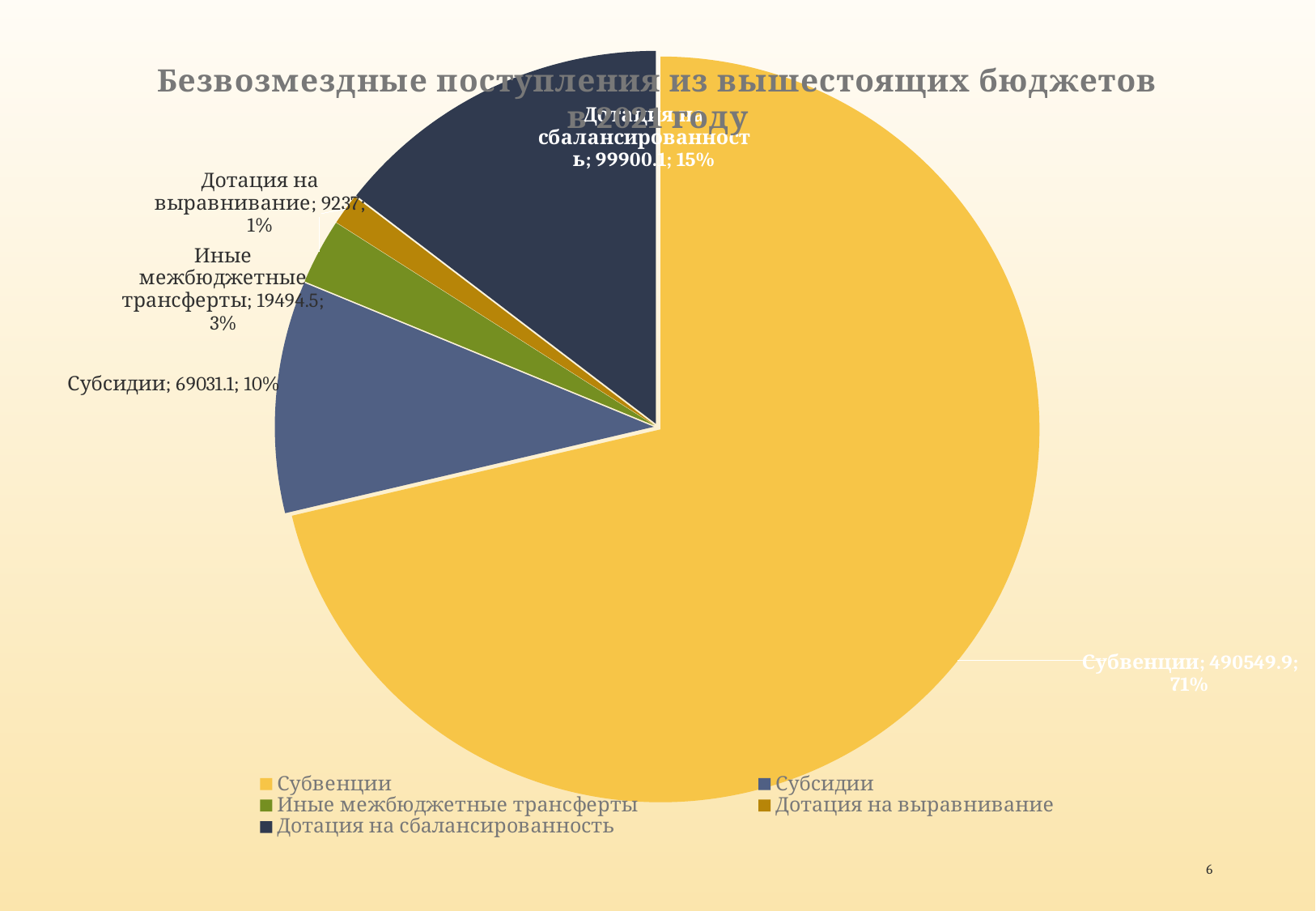
What is the difference between the values for Дотация на сбалансированность and Субсидии? 30869 What share of the pie does Иные межбюджетные трансферты represent? 3% What is the value for Дотация на выравнивание? 9237 How many categories does the legend list? 5 What is the value for Субвенции? 490549.9 Which category has the smallest slice? Дотация на выравнивание What kind of chart is shown on the slide? pie chart Which is larger, Субсидии or Дотация на сбалансированность? Дотация на сбалансированность What share of the pie does Субвенции represent? 71% What is the value for Субсидии? 69031.1 Which category has the largest slice? Субвенции What is the value for Дотация на сбалансированность? 99900.1